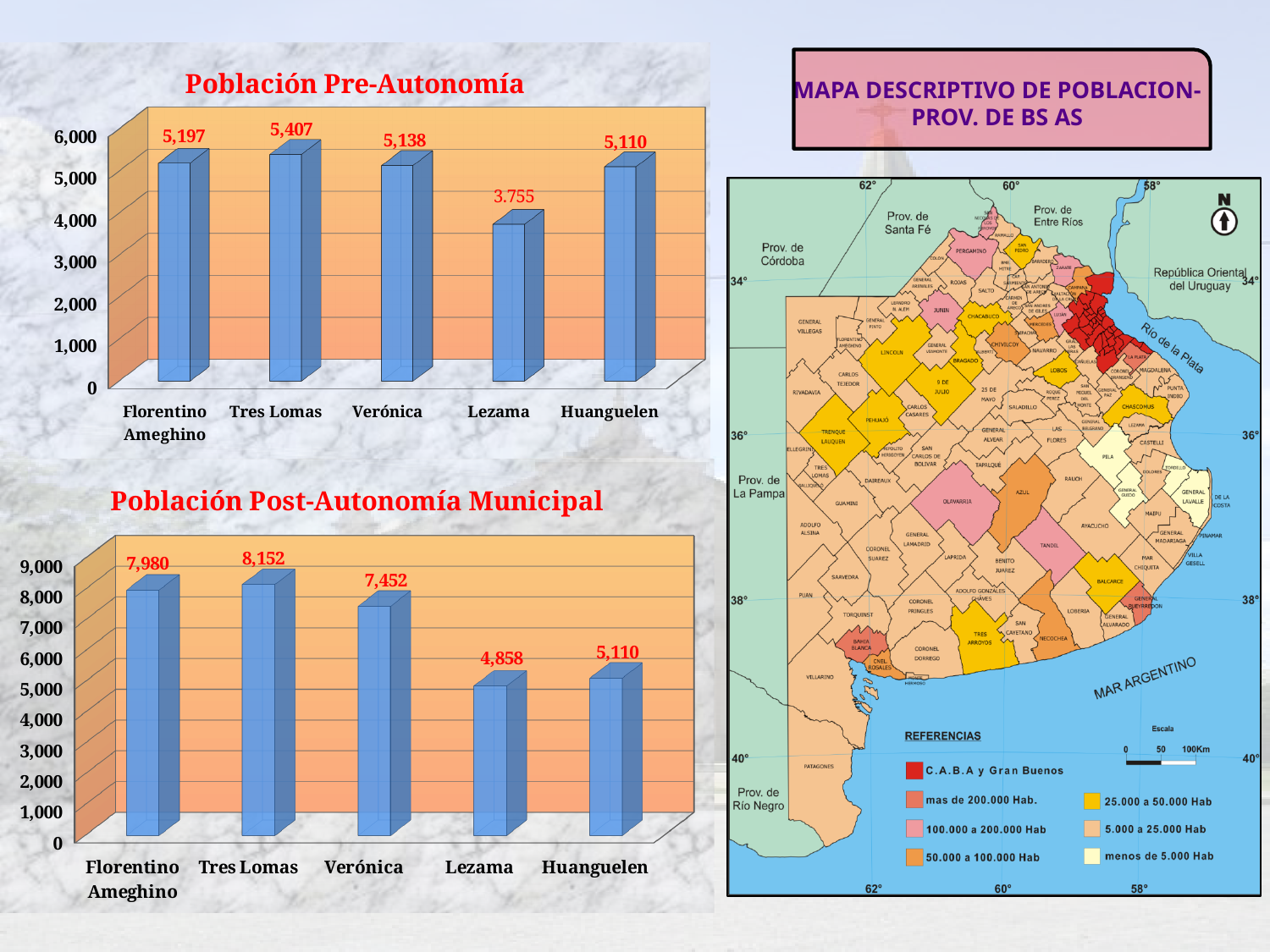
In the 'Población Post-Autonomía Municipal' chart, what is the difference between Tres Lomas and Florentino Ameghino? 172 In the 'Población Pre-Autonomía' chart, what is the value for Tres Lomas? 5,407 In the 'Población Pre-Autonomía' chart, which category has the highest value? Tres Lomas In the 'Población Pre-Autonomía' chart, what is the value for Lezama? 3.755 In the 'Población Post-Autonomía Municipal' chart, what is the value for Lezama? 4,858 In the 'Población Post-Autonomía Municipal' chart, what is the value for Verónica? 7,452 In the 'Población Post-Autonomía Municipal' chart, which is larger, Huanguelen or Lezama? Huanguelen In the 'Población Post-Autonomía Municipal' chart, which category has the highest value? Tres Lomas In the 'Población Pre-Autonomía' chart, what is the difference between Florentino Ameghino and Huanguelen? 87 How many categories are shown in the 'Población Pre-Autonomía' chart? 5 In the 'Población Post-Autonomía Municipal' chart, which category has the lowest value? Lezama In the 'Población Pre-Autonomía' chart, which category has the lowest value? Lezama